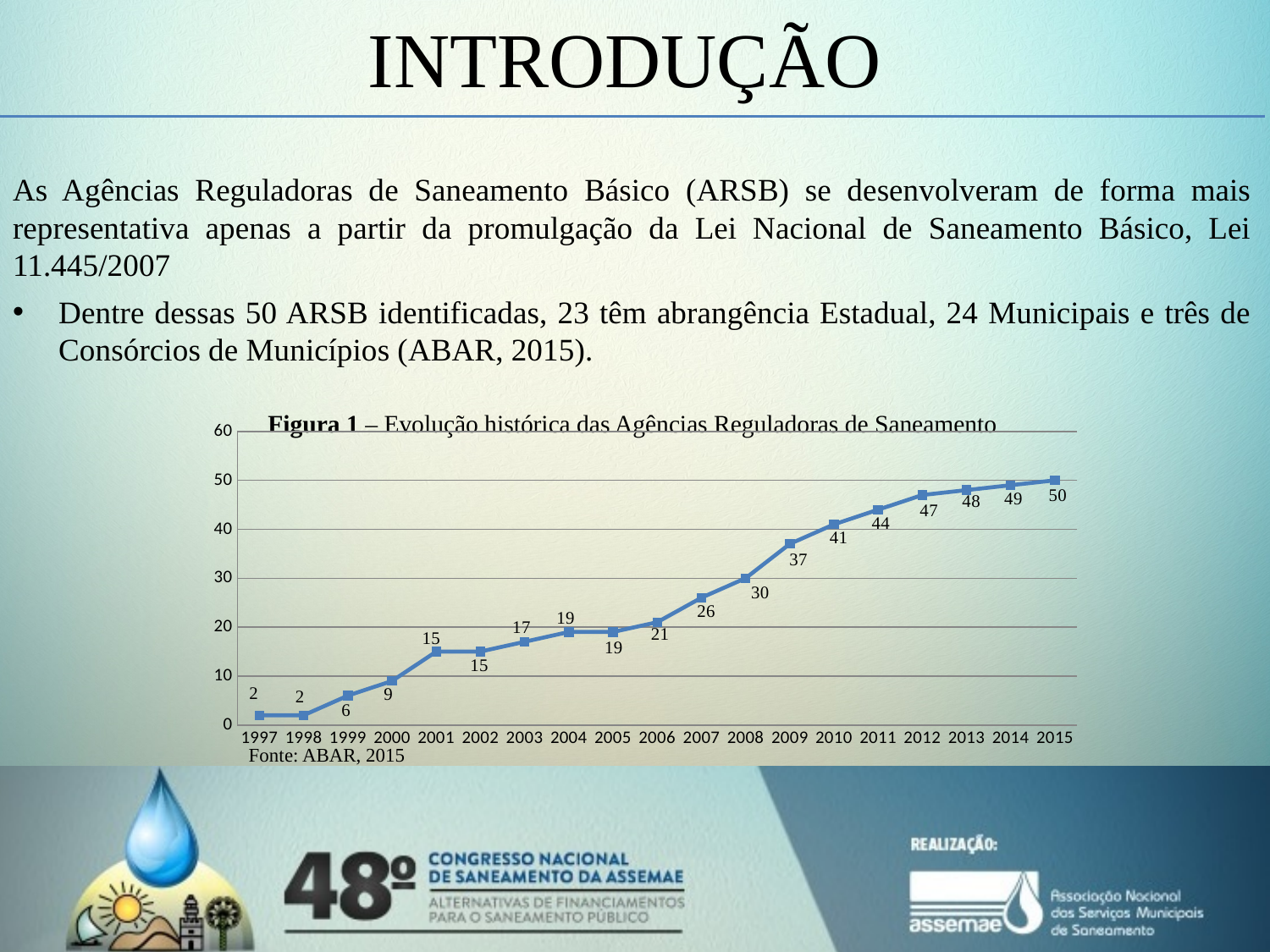
What is the value for 2015 in the chart? 50 What is the lowest value shown in the chart? 2 What is the value for 2009 in the chart? 37 What is the difference between the values for 2015 and 1997? 48 Do the values generally rise or fall from 1997 to 2015? rise Is the value for 2010 greater or less than 40? greater Which is larger, the value for 2006 or the value for 2007? 2007 What kind of chart is shown on the slide? line chart What is the value for 2001 in the chart? 15 Which year has the highest value in the chart? 2015 How many years are plotted on the x axis of the chart? 19 What is the difference between the values for 2009 and 2008? 7